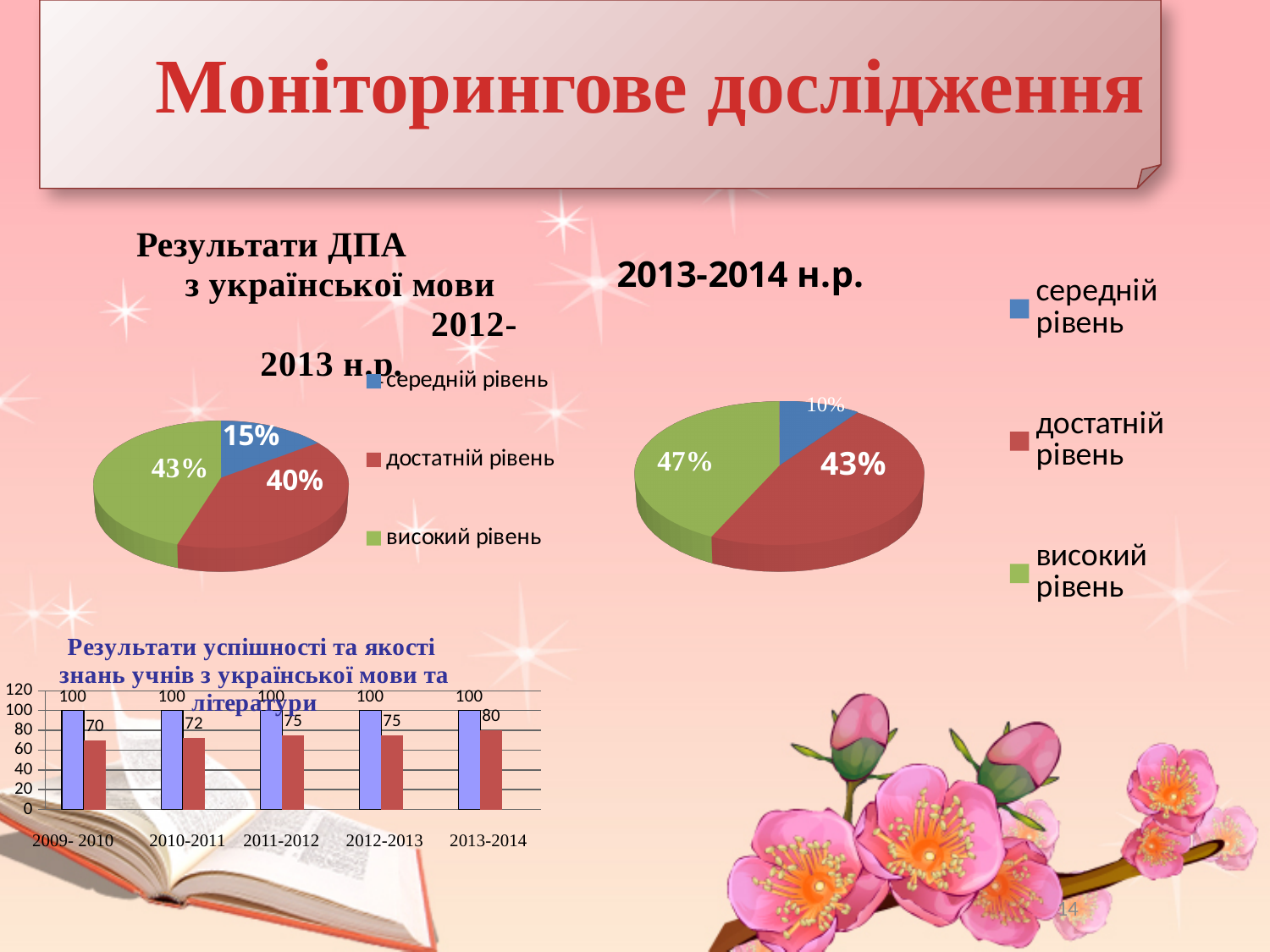
How many series does the legend of the 2013-2014 pie chart list? 3 In the 2012-2013 pie chart, what share is labelled for достатній рівень? 40% In the 2013-2014 pie chart, how many percentage points larger is достатній рівень than середній рівень? 33 In the 2013-2014 pie chart, which level has the smallest share? середній рівень In the bottom-left bar chart, do the red bars rise or fall from 2009-2010 to 2013-2014? rise In the bottom-left bar chart, what is the difference between the blue bar and the red bar for 2010-2011? 28 What kind of chart is the chart at the bottom left titled 'Результати успішності та якості знань учнів з української мови та літератури'? bar chart In the 2013-2014 pie chart, what share is labelled for високий рівень? 47% In the bottom-left bar chart, how many year categories are shown on the x axis? 5 In the 2012-2013 pie chart, what share is labelled for середній рівень? 15% In the bottom-left bar chart, what is the value of the red bar for 2013-2014? 80